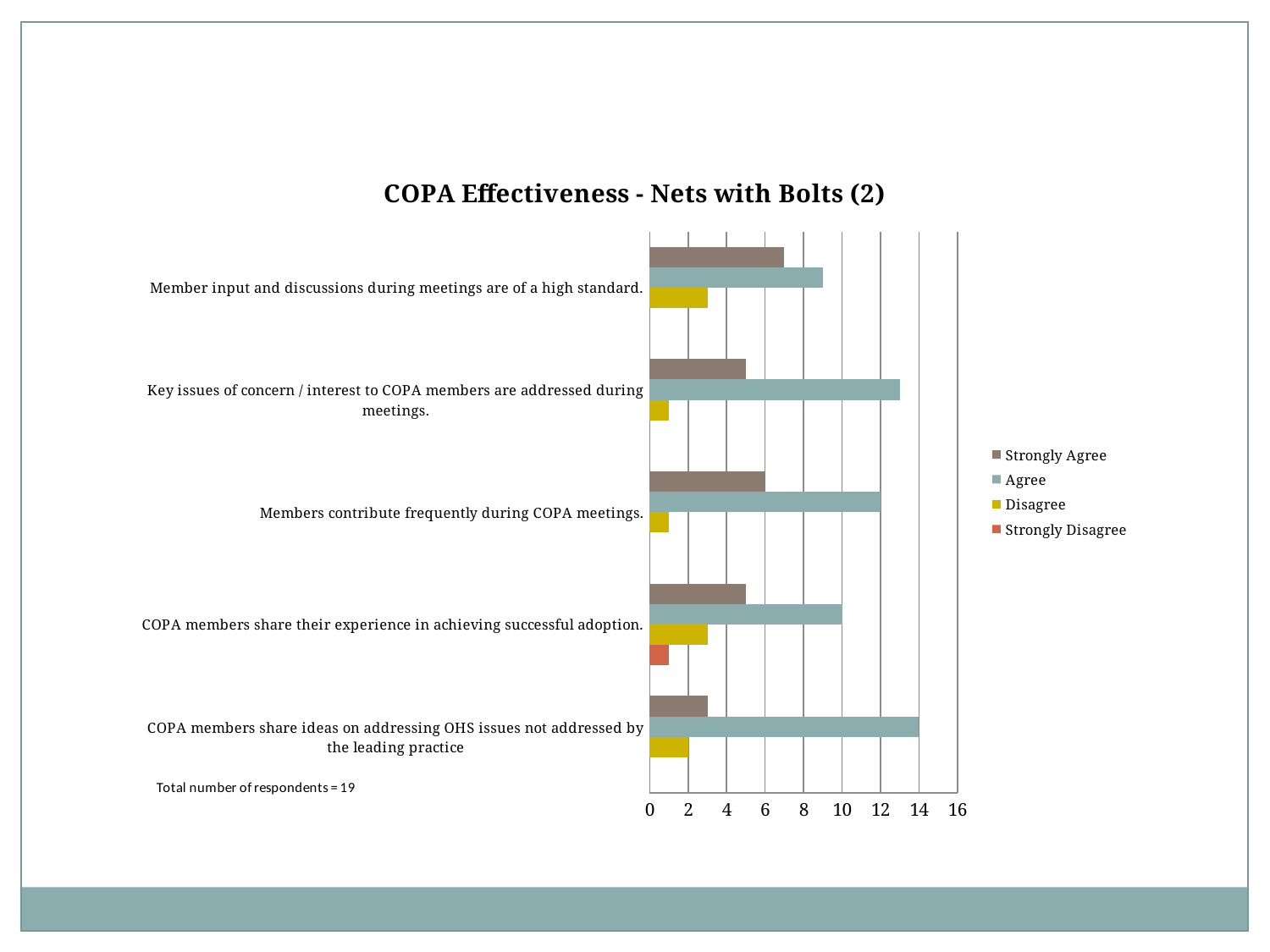
How many series does the legend list? 4 For "COPA members share ideas on addressing OHS issues not addressed by the leading practice", what is the difference between the Agree value and the Disagree value? 12 What is the title of the chart? COPA Effectiveness - Nets with Bolts (2) What is the Agree value for "Members contribute frequently during COPA meetings."? 12 What is the Agree value for "COPA members share their experience in achieving successful adoption."? 10 Is the Agree value for "Key issues of concern / interest to COPA members are addressed during meetings." greater or less than 12? greater Which statement is the only one with a Strongly Disagree bar? COPA members share their experience in achieving successful adoption. How many statements (categories) are plotted on the chart? 5 Which statement has the lowest Strongly Agree value? COPA members share ideas on addressing OHS issues not addressed by the leading practice What is the Strongly Agree value for "Members contribute frequently during COPA meetings."? 6 What is the Agree value for "COPA members share ideas on addressing OHS issues not addressed by the leading practice"? 14 What kind of chart is shown on the slide? Bar chart